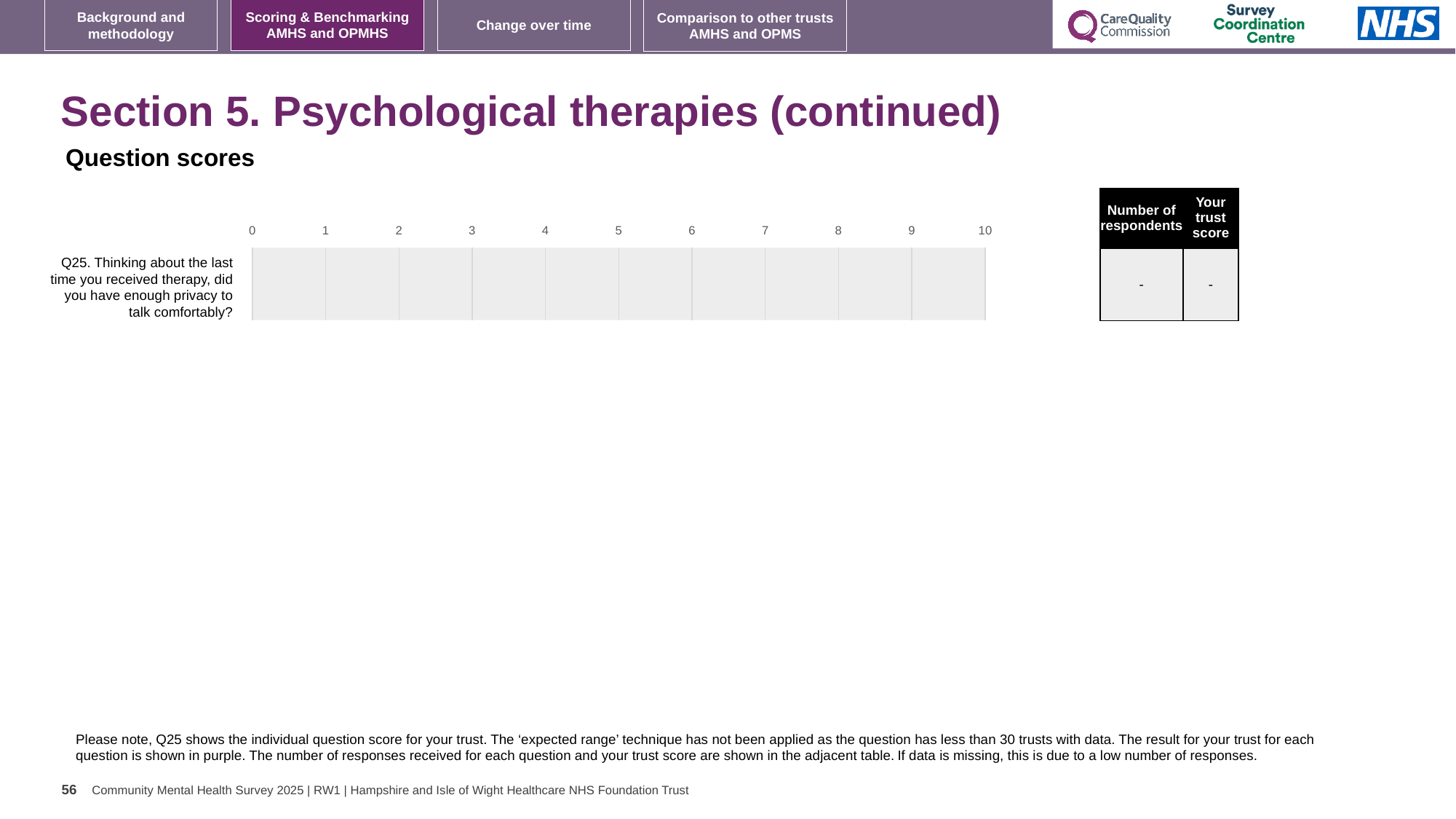
Is a bar plotted for Q25 on the chart? No How many question categories are listed on the chart's vertical axis? 1 What value is shown in the 'Your trust score' column of the table for Q25? - What value is shown in the 'Number of respondents' column of the table for Q25? - What is the heading above the chart? Question scores What is the lowest value shown on the chart's horizontal axis? 0